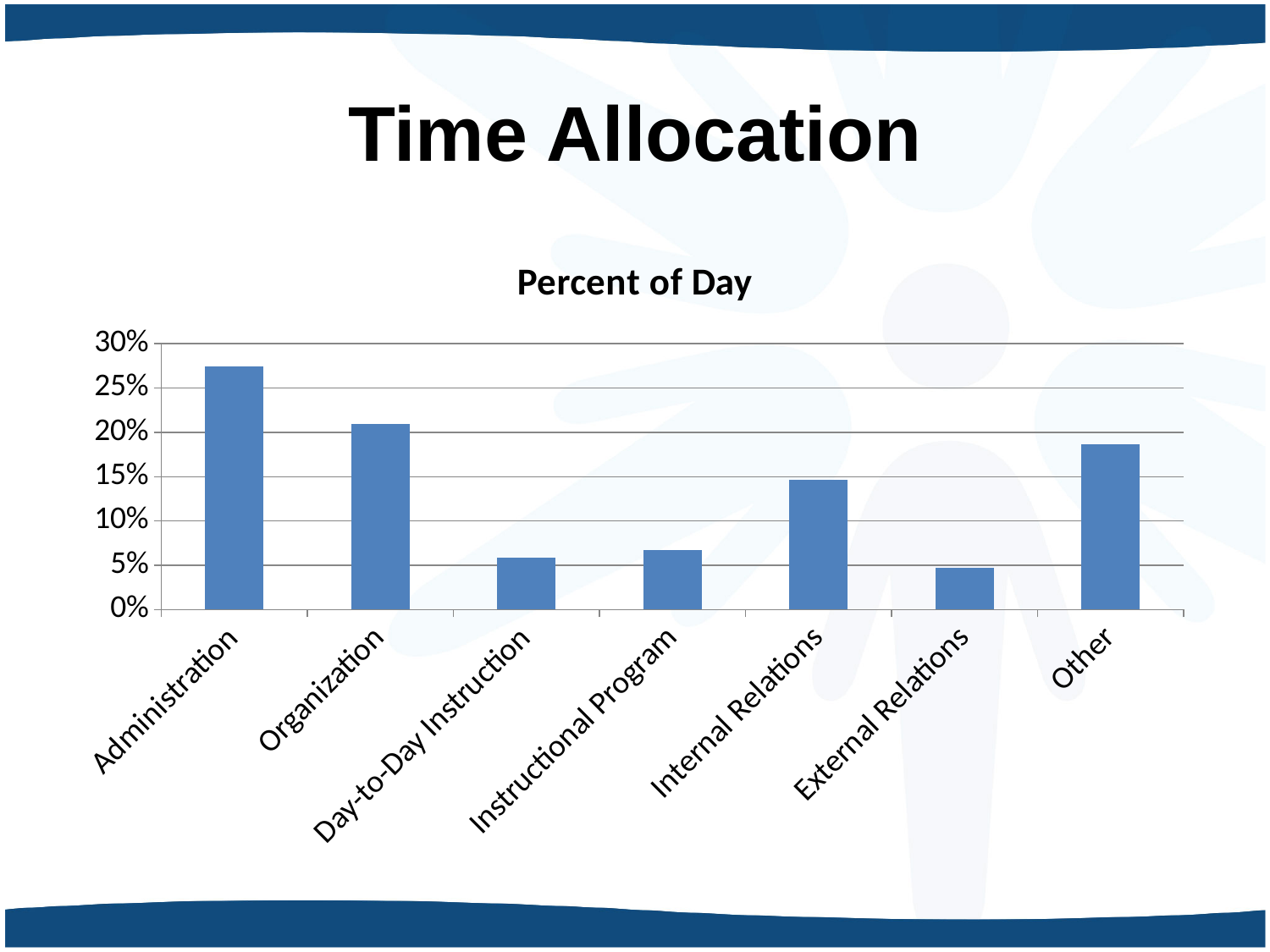
Is the value for Administration greater or less than 25%? greater What is the title of the chart? Percent of Day Which category has the highest percent of day? Administration Is the value for Internal Relations greater or less than 10%? greater What kind of chart is shown on the slide? bar chart Which is larger, the value for Organization or the value for Other? Organization Which is larger, the value for Internal Relations or the value for Instructional Program? Internal Relations Is the value for Day-to-Day Instruction greater or less than 10%? less How many categories are shown on the x axis of the chart? 7 Which category has the lowest percent of day? External Relations